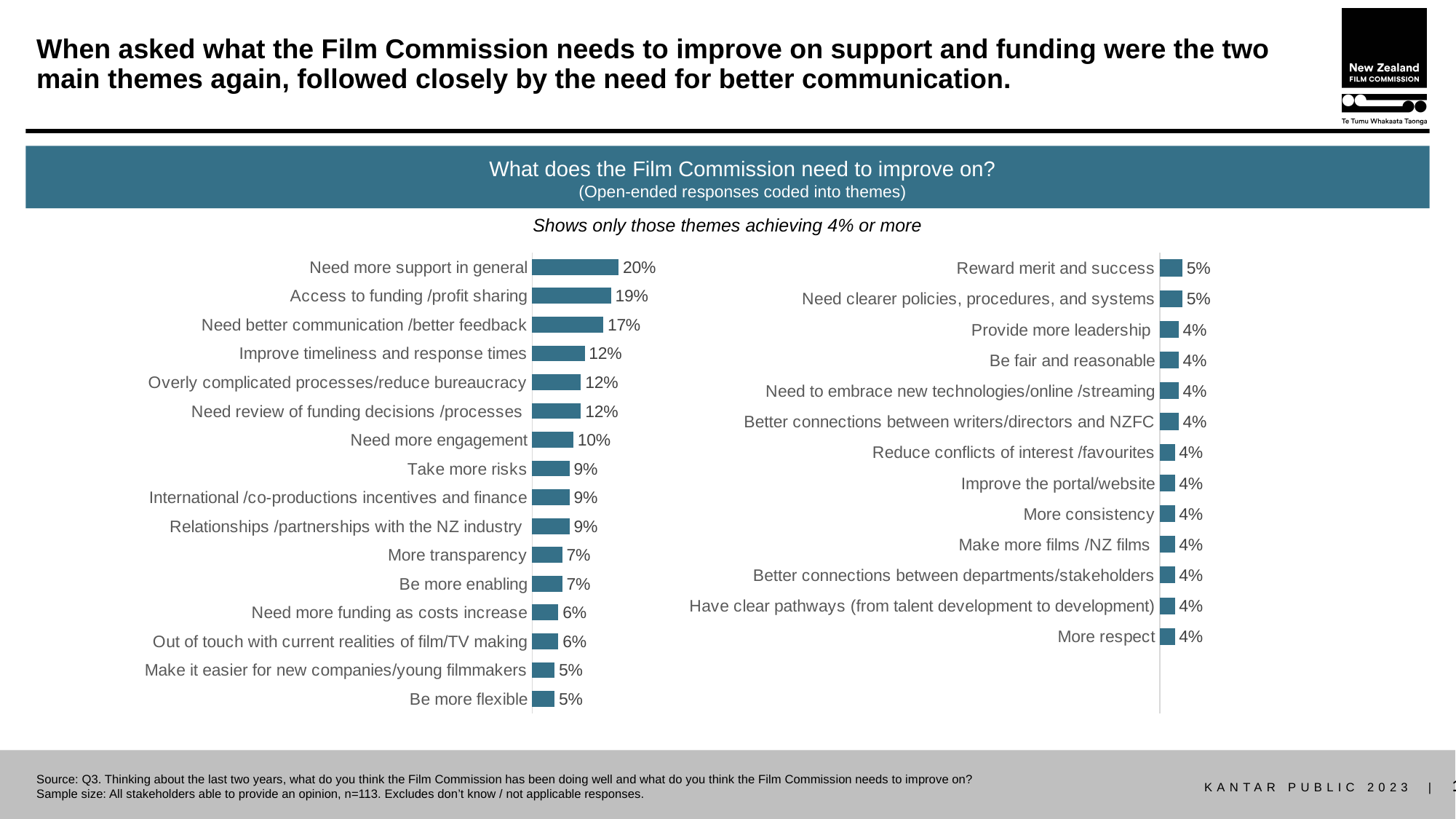
What type of chart is used on this slide? Bar chart In the left chart, what percentage is shown for 'Need more support in general'? 20% What is the title of the chart on this slide? What does the Film Commission need to improve on? In the right chart, what percentage is shown for 'Reward merit and success'? 5% In the left chart, what is the difference between 'Access to funding /profit sharing' and 'Need more engagement'? 9% In the left chart, what percentage is shown for 'Need better communication /better feedback'? 17% In the left chart, which theme has the highest percentage? Need more support in general How many themes are plotted in the left chart? 16 In the left chart, what is the difference between 'Need more support in general' and 'Be more flexible'? 15% In the left chart, which is larger: 'Improve timeliness and response times' or 'Take more risks'? Improve timeliness and response times In the right chart, what percentage is shown for 'More respect'? 4% How many themes are plotted in the right chart? 13